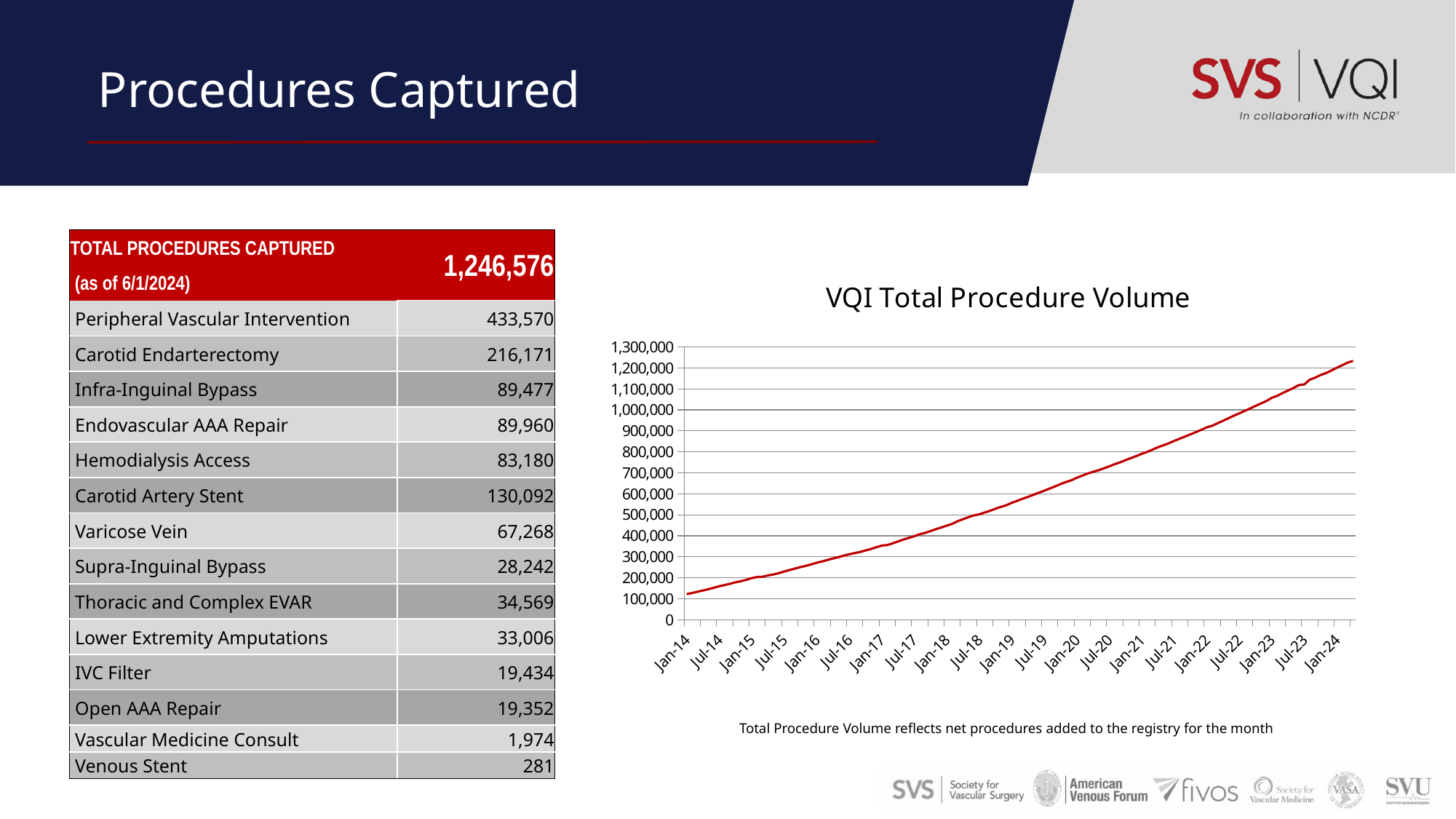
In the VQI Total Procedure Volume chart, at which x-axis label is the plotted value highest? Jan-24 In the VQI Total Procedure Volume chart, is the value for Jan-14 greater or less than 200,000? less How many x-axis labels are shown on the VQI Total Procedure Volume chart? 21 In the VQI Total Procedure Volume chart, is the value for Jan-24 greater or less than 1,100,000? greater What is the title of the chart on the right side of the slide? VQI Total Procedure Volume In the VQI Total Procedure Volume chart, is the value for Jan-20 greater or less than 600,000? greater What kind of chart is the VQI Total Procedure Volume chart? line chart In the VQI Total Procedure Volume chart, do the values rise or fall from Jan-14 to Jan-24? rise In the VQI Total Procedure Volume chart, which is larger, the value for Jan-20 or the value for Jan-16? Jan-20 In the VQI Total Procedure Volume chart, at which x-axis label is the plotted value lowest? Jan-14